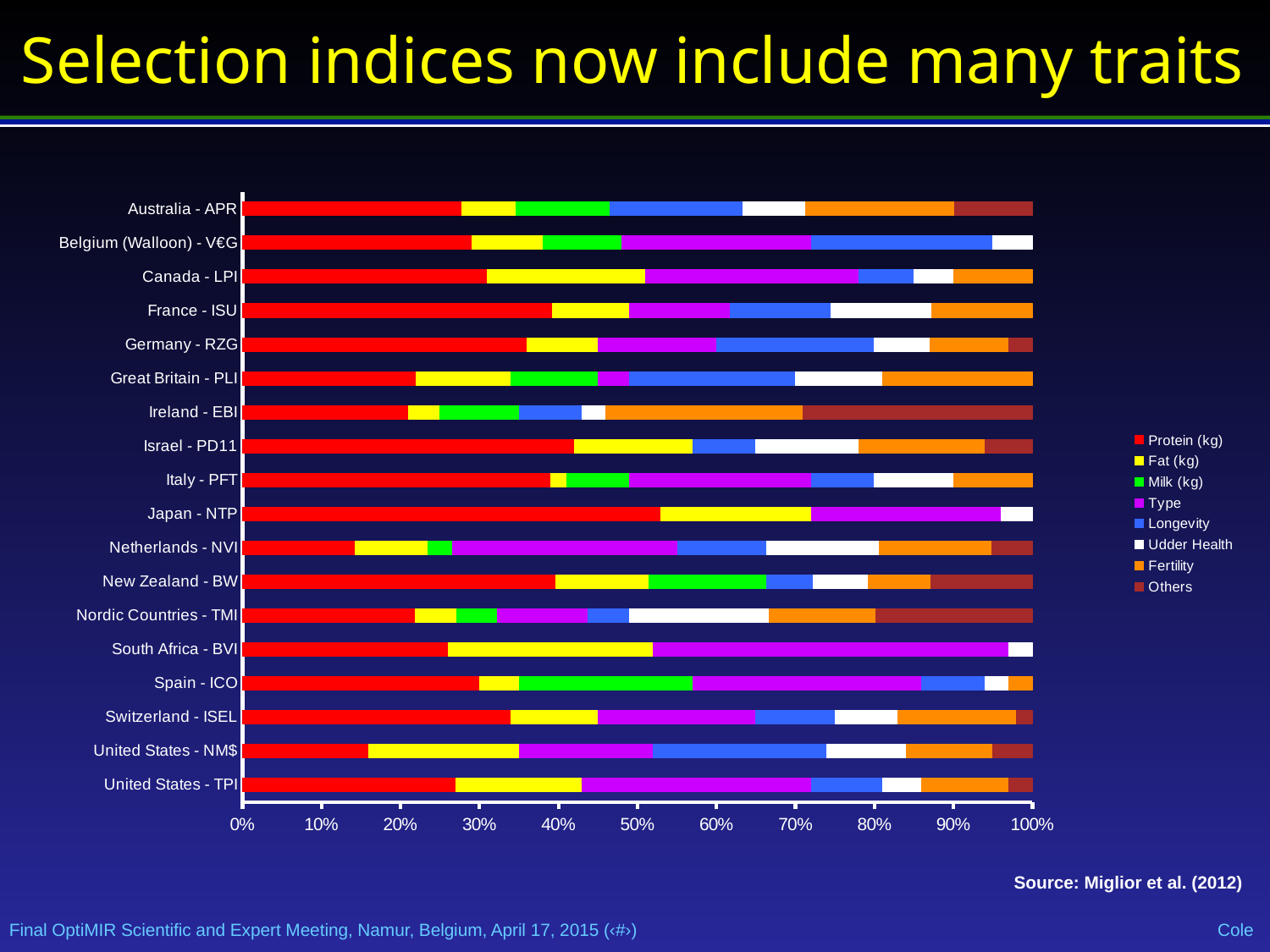
Which index has the largest Type share? South Africa - BVI How many series does the legend list? 8 Is the Protein (kg) share for Netherlands - NVI greater or less than 20%? less Which index has the largest Protein (kg) share? Japan - NTP Which has the larger Protein (kg) share, Japan - NTP or Netherlands - NVI? Japan - NTP Which index has the largest Milk (kg) share? Spain - ICO What colour represents Fertility in the legend? Orange What kind of chart is shown on the slide? Stacked bar chart Is the Protein (kg) share for Japan - NTP greater or less than 40%? greater How many country/index categories are plotted on the chart? 18